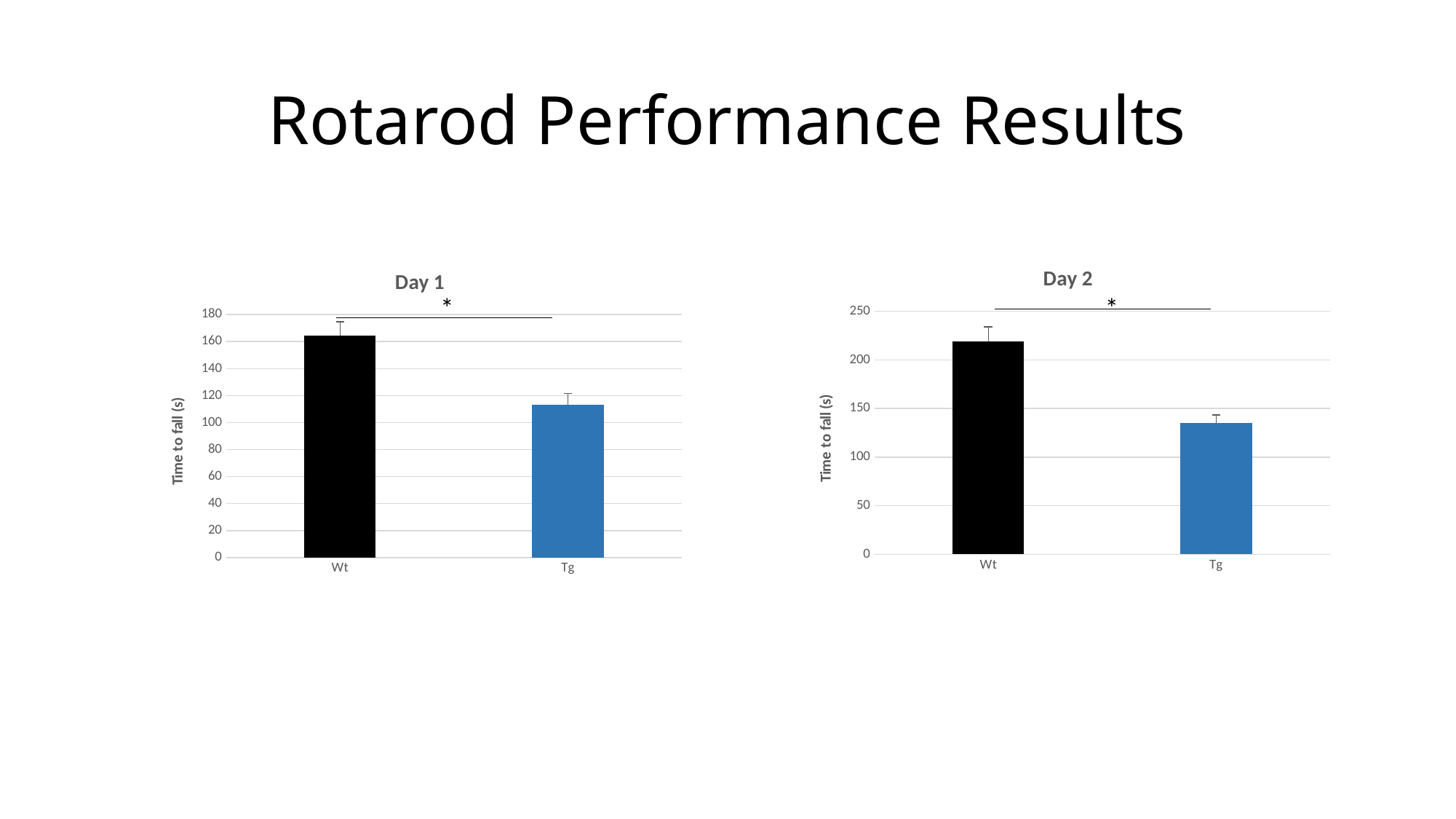
What kind of chart is the Day 2 chart? Bar chart In the Day 2 chart, which category has the lowest time to fall? Tg In the Day 2 chart, is the value for Wt greater or less than 200? greater In the Day 1 chart, is the value for Tg greater or less than 140? less How many categories are shown in the Day 1 chart? 2 In the Day 2 chart, which is larger, the value for Wt or the value for Tg? Wt In the Day 2 chart, is the value for Tg greater or less than 150? less In the Day 1 chart, which category has the highest time to fall? Wt In the Day 1 chart, which category has the lowest time to fall? Tg What is the y-axis label of the Day 1 chart? Time to fall (s) In the Day 2 chart, which category has the highest time to fall? Wt